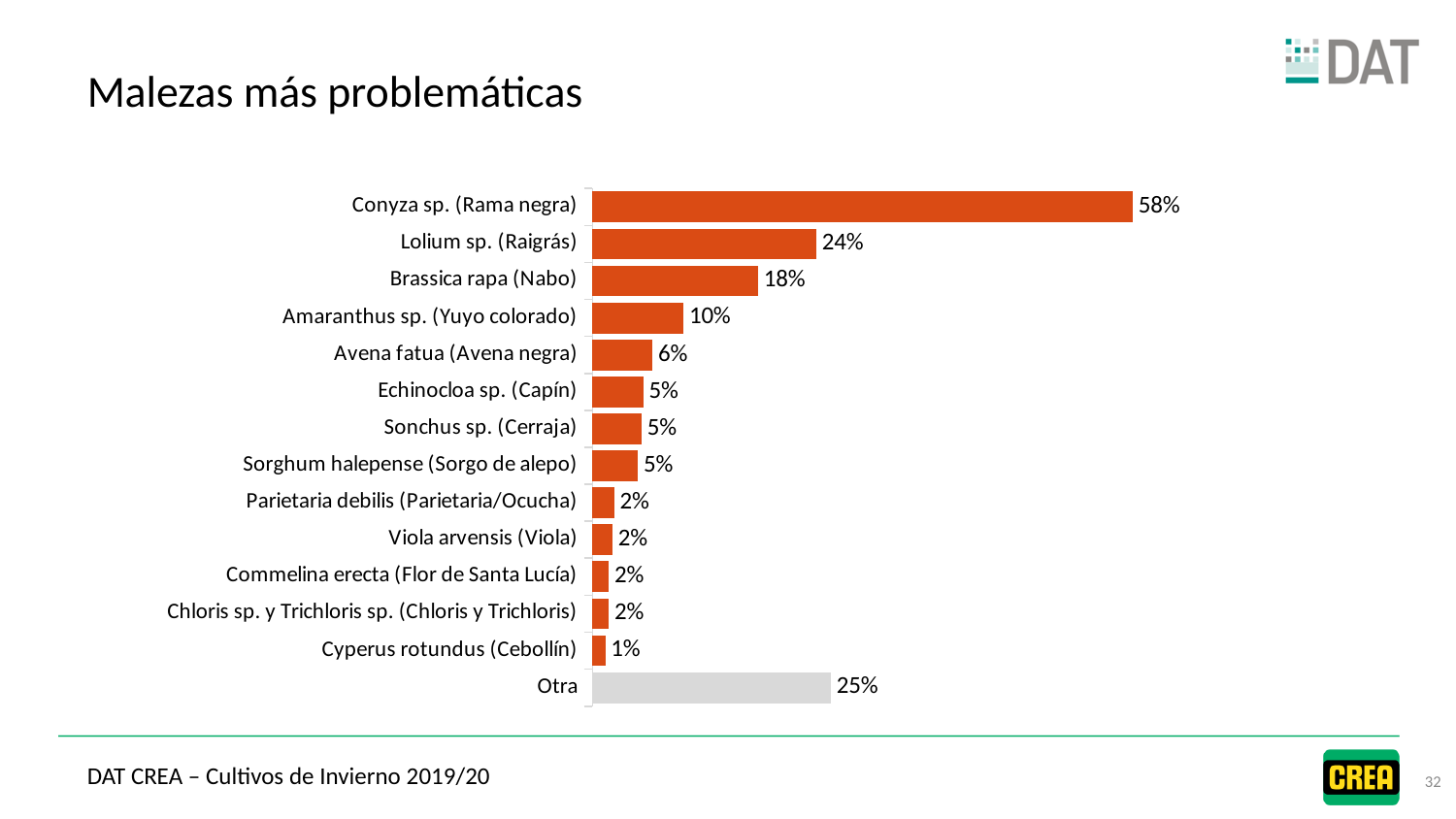
What is the value for Cyperus rotundus (Cebollín)? 1% What is the value for Lolium sp. (Raigrás)? 24% What is the difference between the values for Conyza sp. (Rama negra) and Lolium sp. (Raigrás)? 34% Which category has the highest value? Conyza sp. (Rama negra) What is the value for Conyza sp. (Rama negra)? 58% Which category has the lowest value? Cyperus rotundus (Cebollín) How many categories are shown in the chart? 14 Which is larger, the value for Otra or the value for Lolium sp. (Raigrás)? Otra What is the title of the chart? Malezas más problemáticas What is the value for Brassica rapa (Nabo)? 18% What kind of chart is shown on the slide? Bar chart What is the value for Otra? 25%